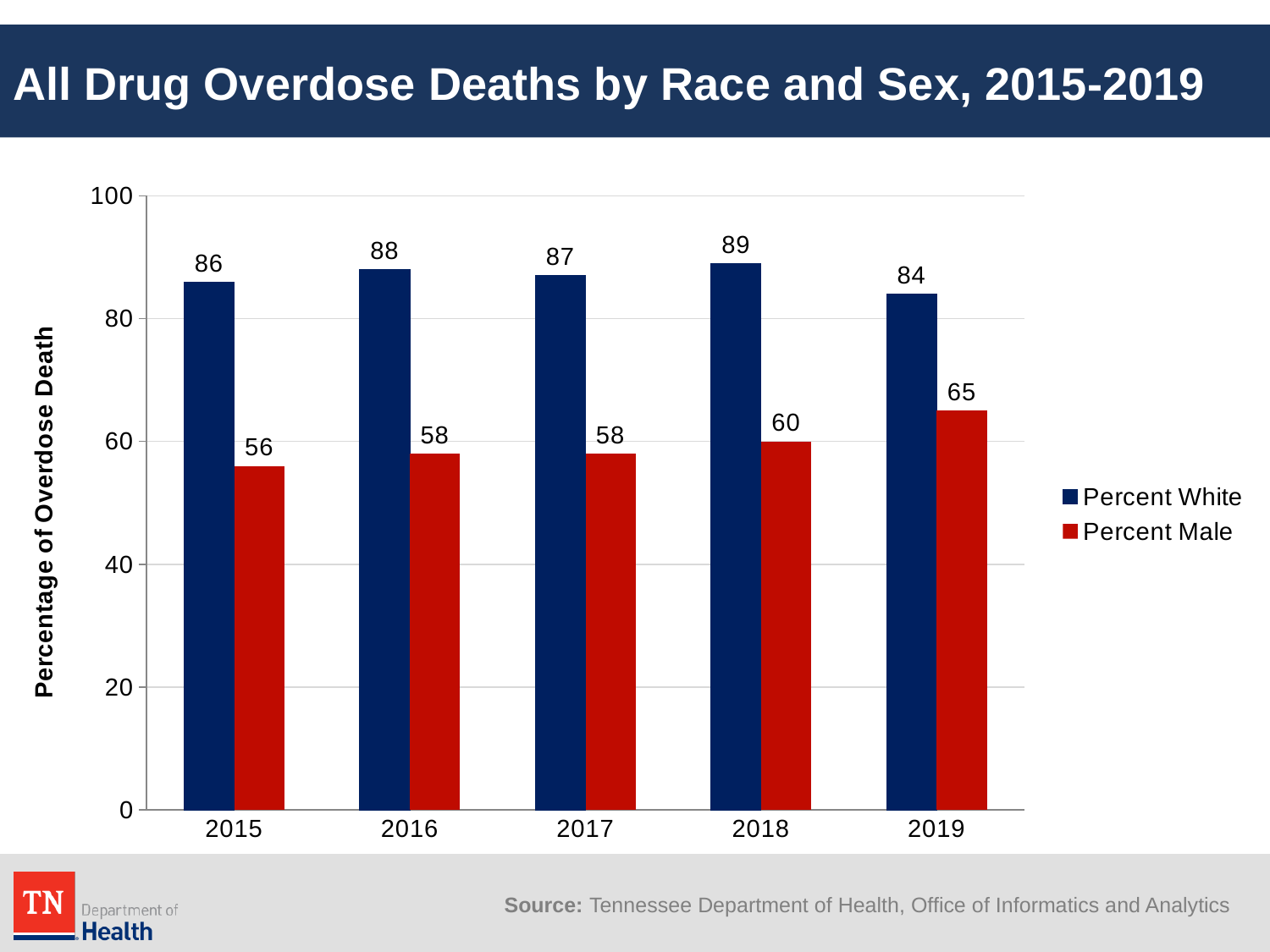
Does the Percent Male value rise or fall from 2015 to 2019? rise What kind of chart is shown on the slide? bar chart What is the difference between Percent White and Percent Male in 2019? 19 How many series does the legend list? 2 What is the Percent Male value for 2019? 65 In which year is the Percent Male value lowest? 2015 What is the Percent Male value for 2018? 60 How many years are shown on the x axis? 5 In which year is the Percent White value highest? 2018 What is the Percent White value for 2015? 86 Which is larger, the Percent Male value in 2016 or in 2019? 2019 What is the label of the y axis? Percentage of Overdose Death